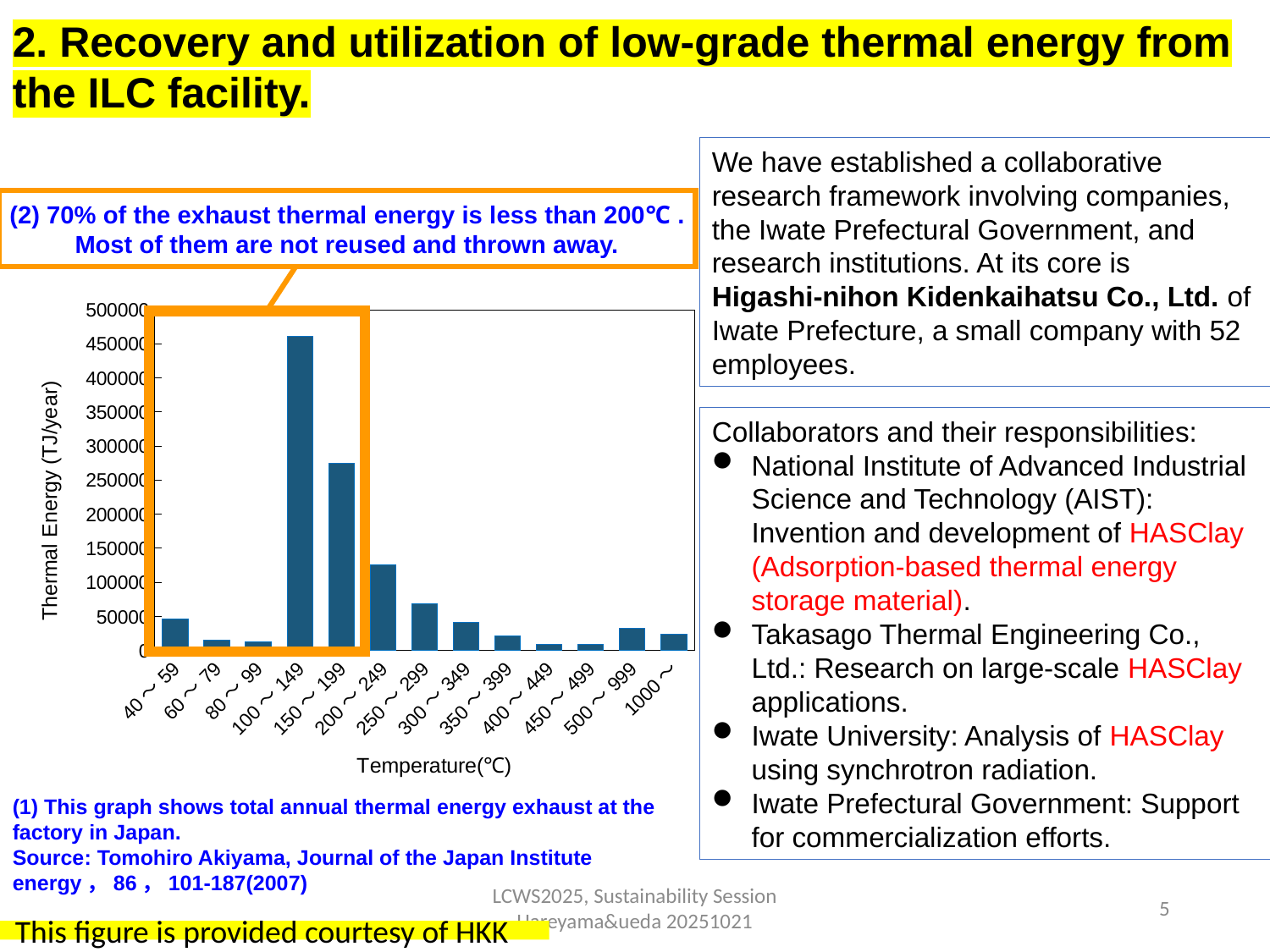
Which is larger, the value for 150～199 or the value for 200～249? 150～199 Is the value for the 150～199 range greater or less than 250000? greater What is the label of the x axis? Temperature(℃) Which temperature range has the highest thermal energy? 100～149 Is the value for the 250～299 range greater or less than 50000? greater Which is larger, the value for 40～59 or the value for 60～79? 40～59 Is the value for the 200～249 range greater or less than 150000? less How many temperature ranges are plotted on the x axis? 13 What kind of chart is shown on the slide? bar chart What is the label of the y axis? Thermal Energy (TJ/year)